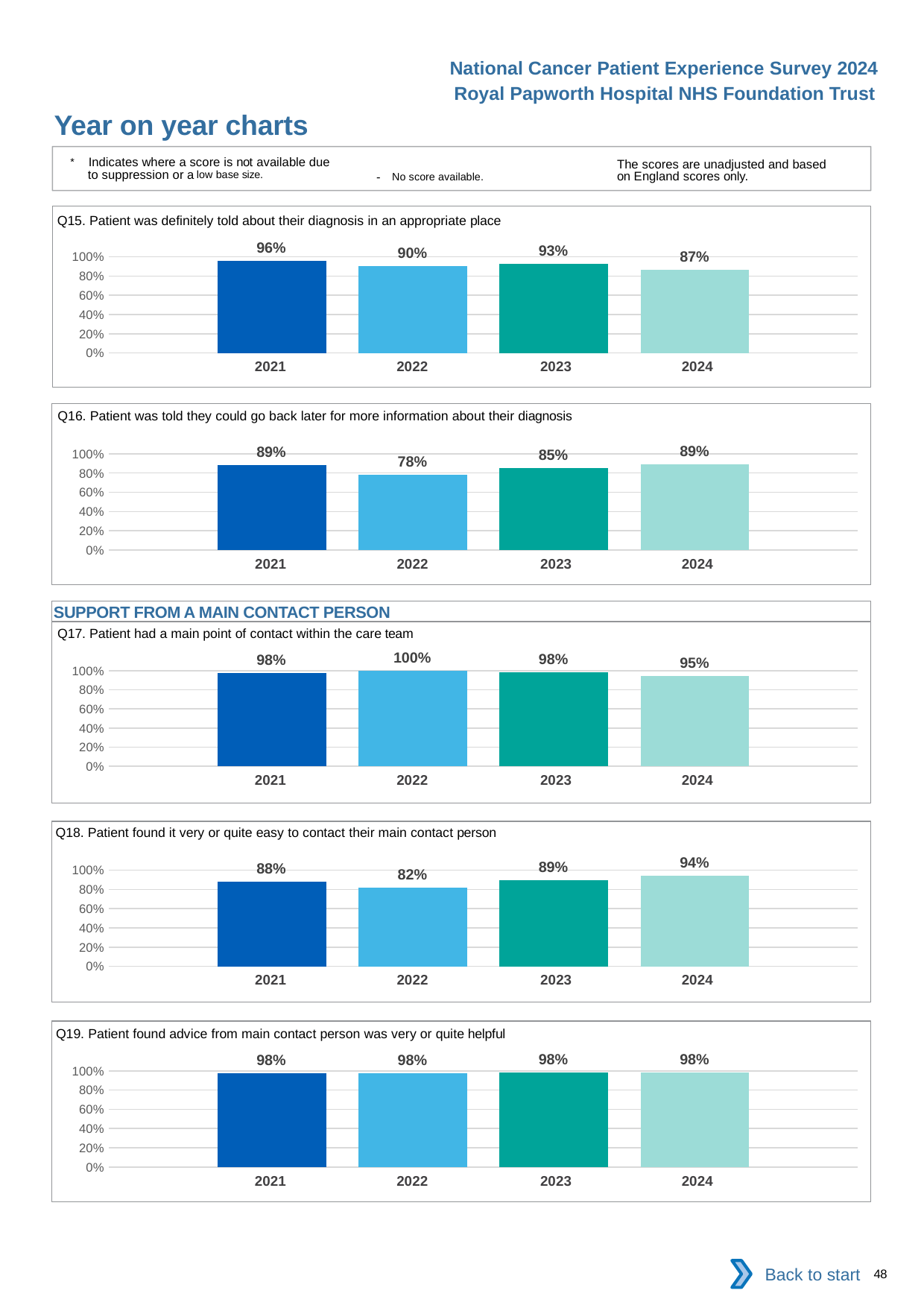
What kind of chart is the Q16 chart? Bar chart How many years are shown on the x axis of the Q18 chart? 4 In the Q16 chart, what is the value for 2022? 78% In the Q15 chart, which year has the lowest value? 2024 In the Q15 chart, what is the value for 2021? 96% In the Q19 chart, do the values rise, fall or stay the same from 2021 to 2024? Stay the same In the Q17 chart, which year has the highest value? 2022 In the Q18 chart, which is larger, the value for 2021 or the value for 2024? 2024 In the Q18 chart, what is the difference between the 2024 and 2022 values? 12 percentage points In the Q16 chart, what is the difference between the 2023 and 2022 values? 7 percentage points In the Q17 chart, what is the value for 2024? 95% In the Q19 chart, what is the value for 2023? 98%